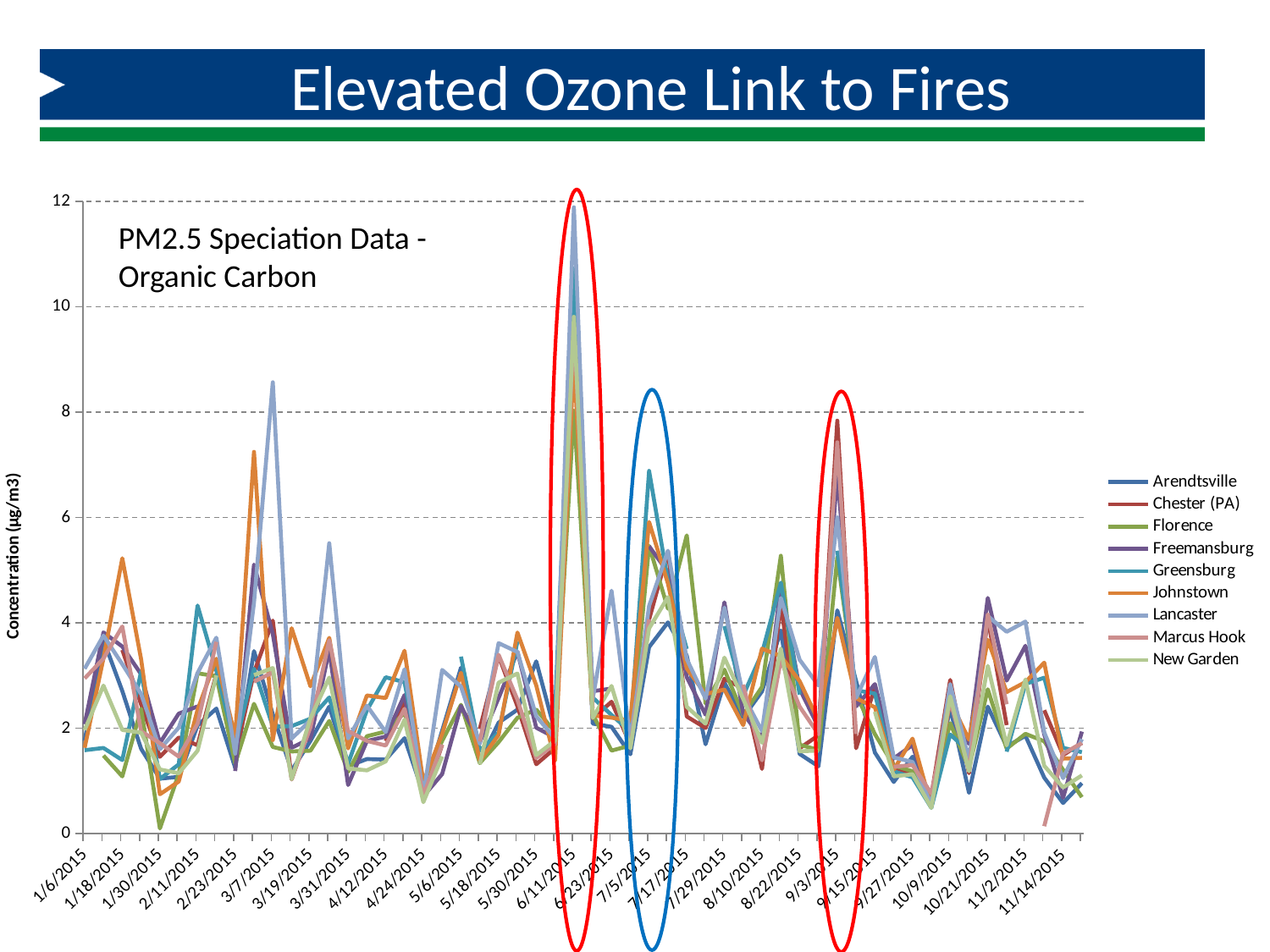
Which series reaches the highest value anywhere on the chart? Lancaster What kind of chart is shown on the slide? line chart What is the title shown inside the chart area? PM2.5 Speciation Data - Organic Carbon Which series has the highest value around 7/5/2015? Greensburg Is the Johnstown value around 1/18/2015 greater or less than 4? greater Is the Florence value around 1/30/2015 greater or less than 1? less What is the label on the y axis? Concentration (µg/m3) Is the Lancaster value around 3/7/2015 greater or less than 8? greater How many series does the legend list? 9